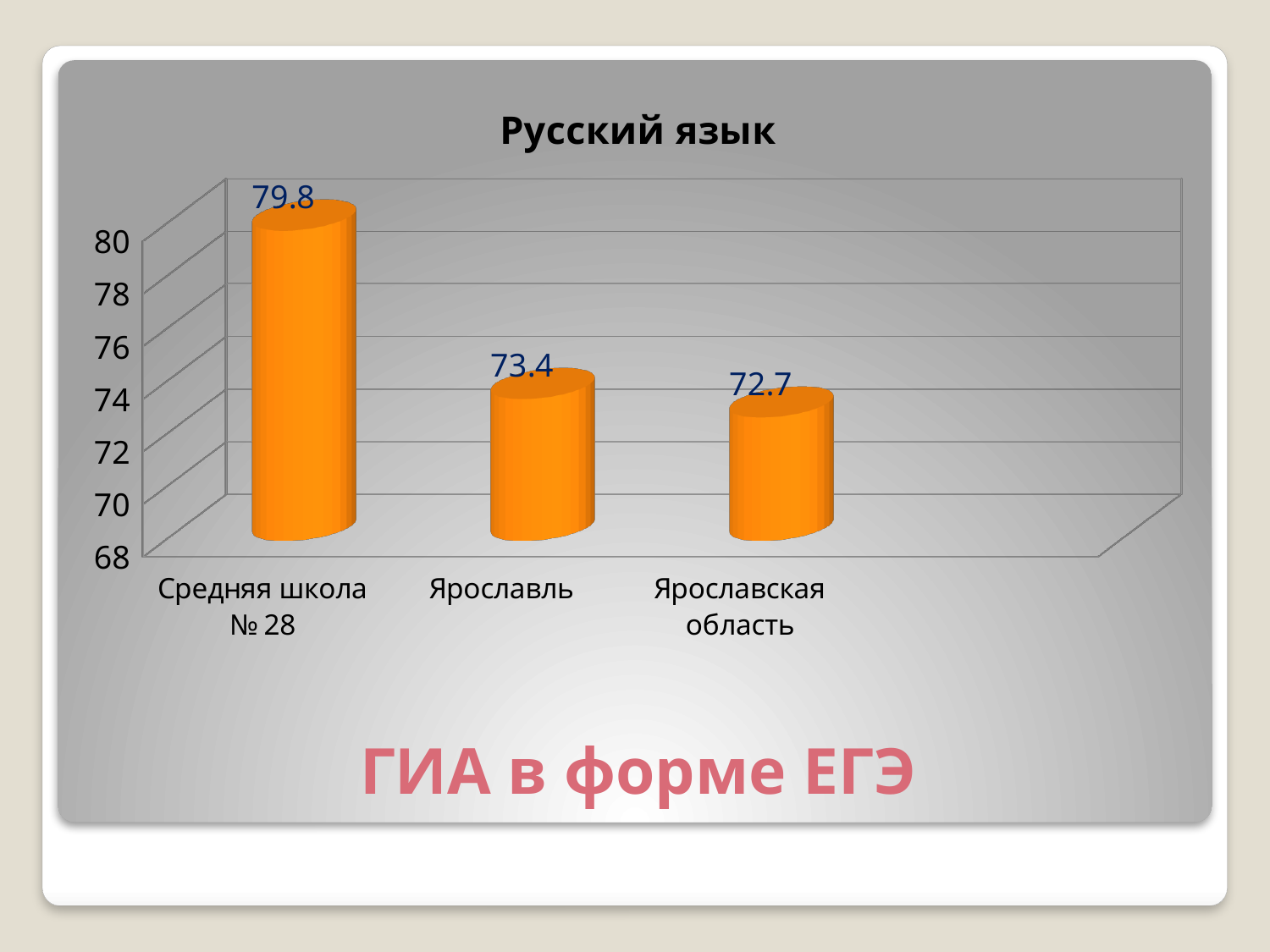
Which category has the lowest value? Ярославская область Which category has the highest value? Средняя школа № 28 Which is larger, the value for Средняя школа № 28 or the value for Ярославская область? Средняя школа № 28 What is the value for Ярославская область? 72.7 What kind of chart is shown on the slide? bar chart What is the title of the chart? Русский язык What is the difference between the values for Ярославль and Ярославская область? 0.7 How many categories are shown in the chart? 3 What is the value for Ярославль? 73.4 Is the value for Ярославль greater or less than 76? less What is the value for Средняя школа № 28? 79.8 What is the difference between the values for Средняя школа № 28 and Ярославль? 6.4